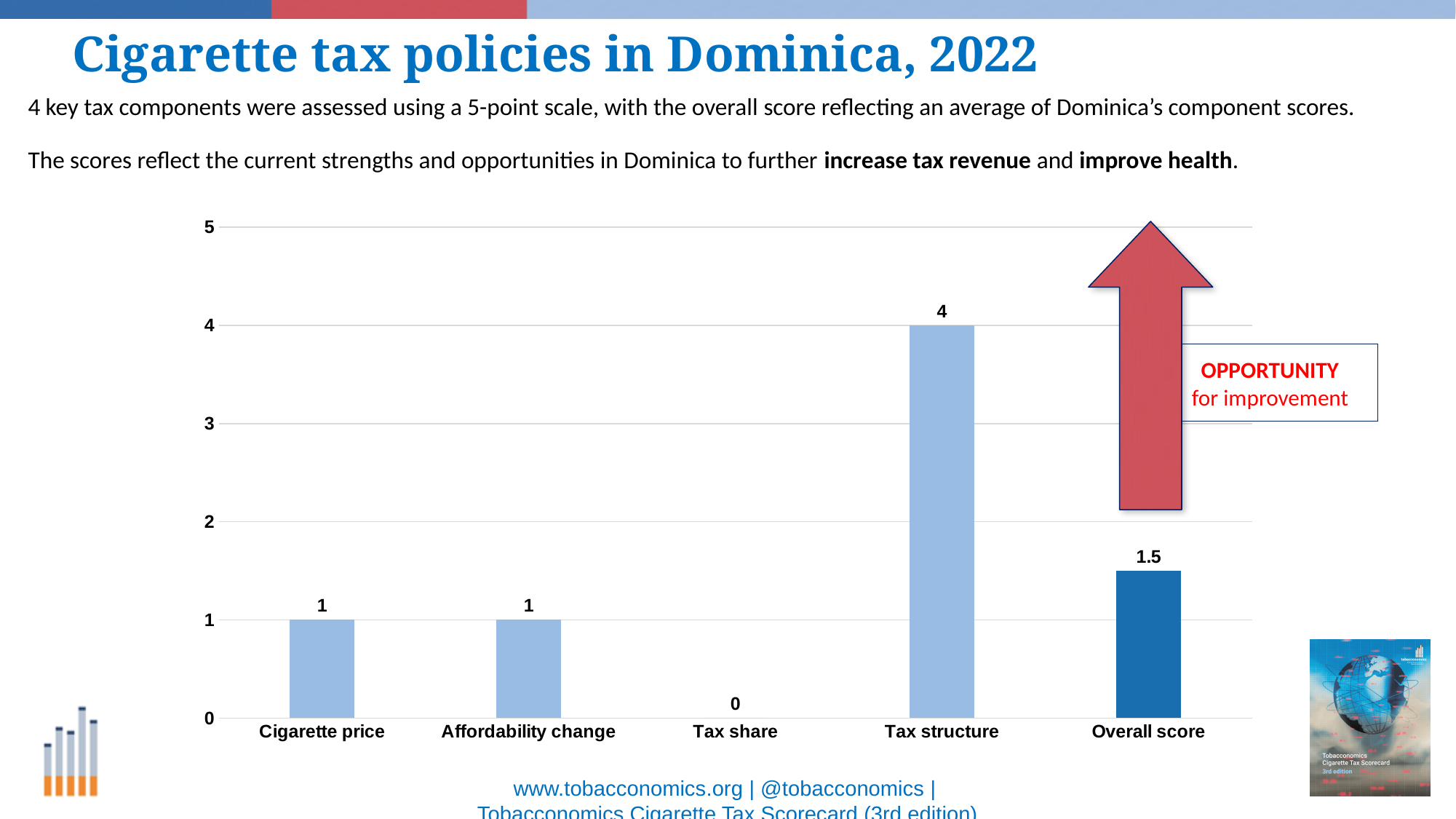
Which category has the lowest value? Tax share What kind of chart is shown on the slide? bar chart Which category has the highest value? Tax structure What is the difference between the values for Tax structure and Overall score? 2.5 Which is larger, the value for Affordability change or the value for Overall score? Overall score What is the value for Overall score? 1.5 Is the value for Tax structure greater or less than 3? greater What is the value for Cigarette price? 1 What is the value for Tax structure? 4 What is the highest value shown on the y axis? 5 What is the value for Tax share? 0 How many categories are shown on the x axis? 5